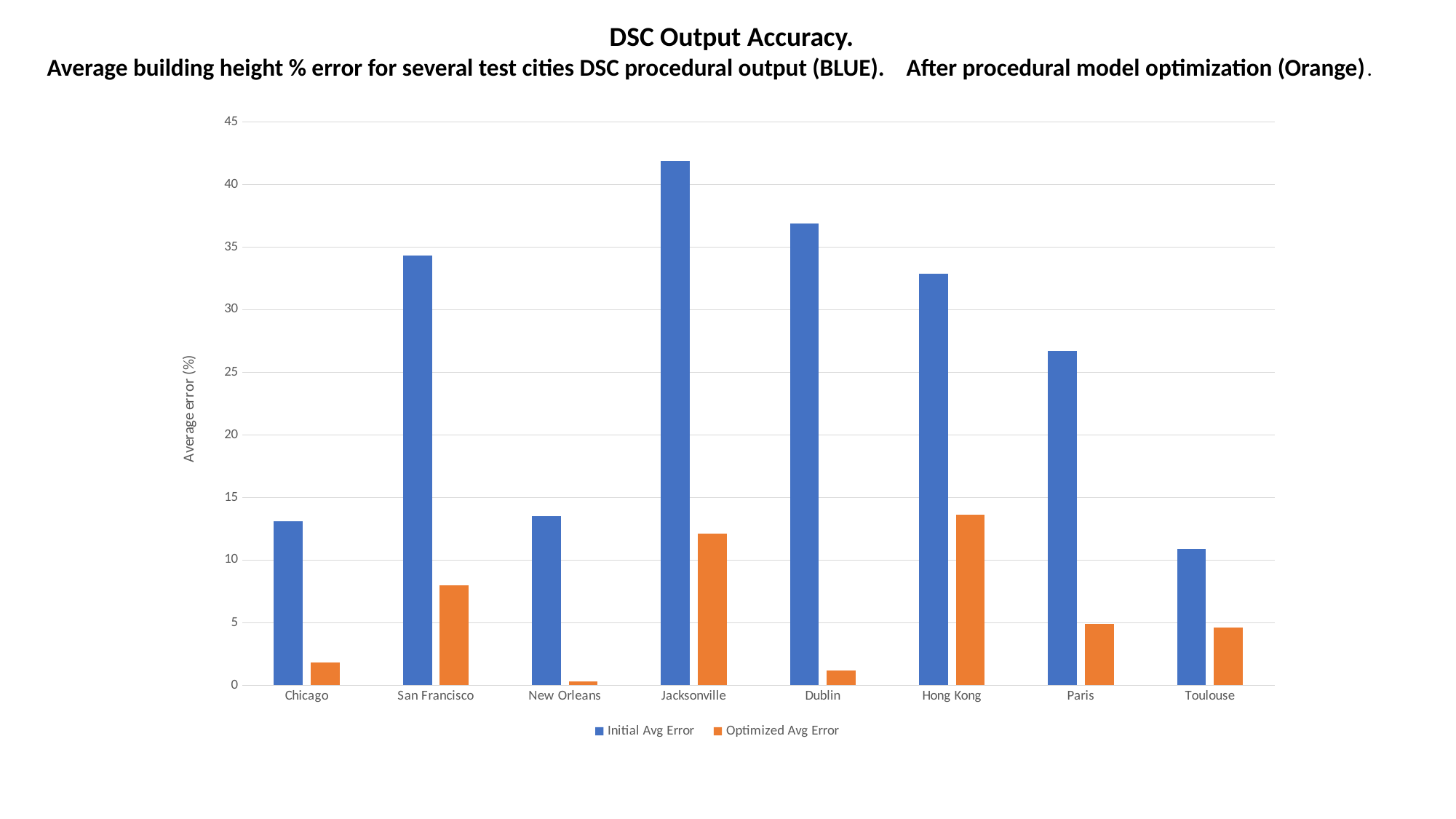
Which city has the highest Initial Avg Error? Jacksonville Is the Optimized Avg Error for San Francisco greater or less than 10? less Is the Initial Avg Error for Paris greater or less than 25? greater How many cities are shown on the x axis of the chart? 8 Which city has the lowest Optimized Avg Error? New Orleans Is the Initial Avg Error for Jacksonville greater or less than 40? greater Which is larger, the Initial Avg Error for Dublin or for Hong Kong? Dublin What kind of chart is shown on the slide? bar chart Which city has the highest Optimized Avg Error? Hong Kong How many series does the legend list? 2 What is the label on the vertical axis of the chart? Average error (%) Which city has the lowest Initial Avg Error? Toulouse